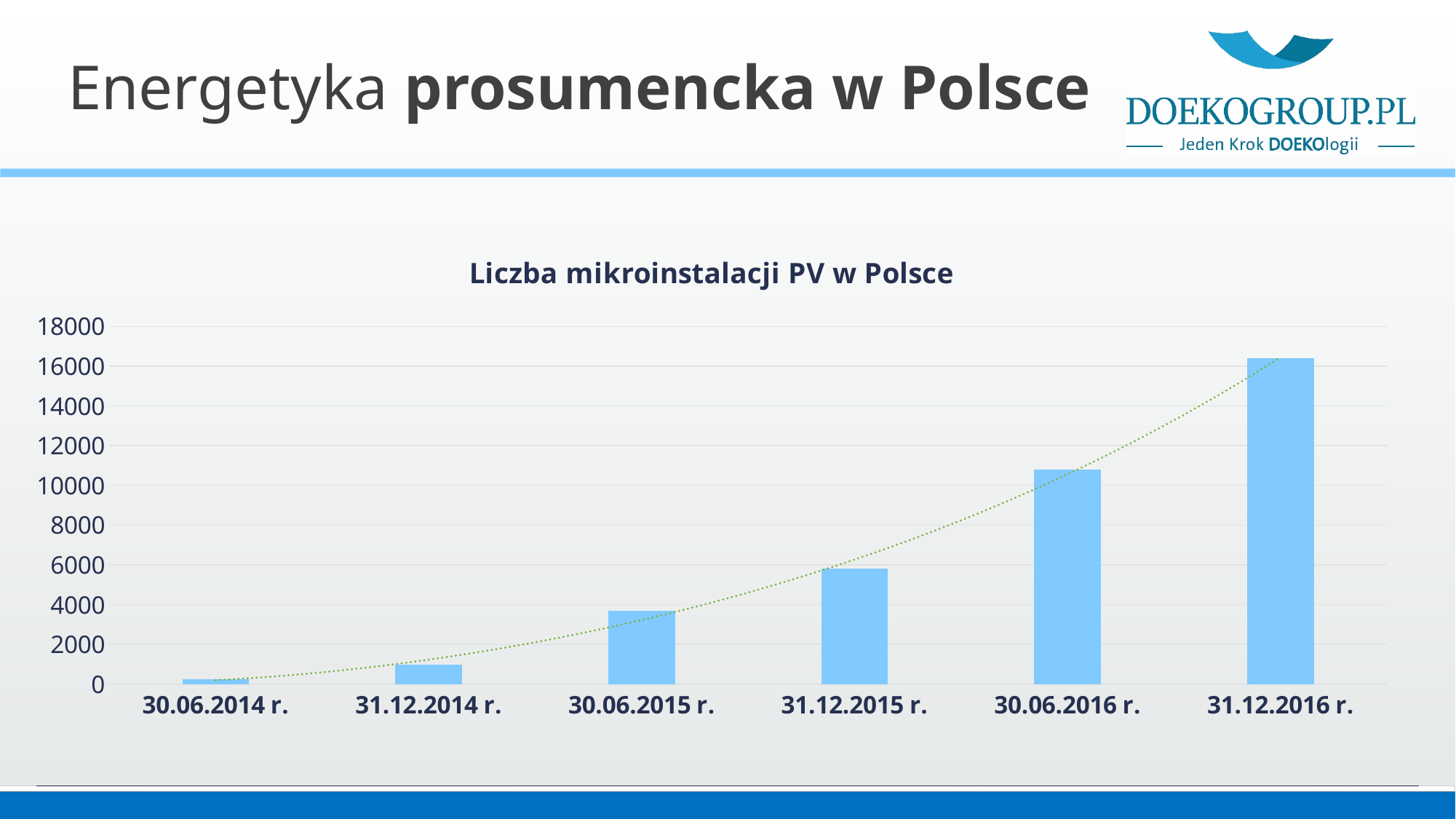
Which is larger, the value for 30.06.2016 r. or the value for 31.12.2015 r.? 30.06.2016 r. What is the highest value shown on the vertical axis of the chart? 18000 Is the value for 31.12.2014 r. greater or less than 2000? less What is the title of the chart? Liczba mikroinstalacji PV w Polsce Is the value for 30.06.2016 r. greater or less than 10000? greater Which date has the highest number of PV micro-installations? 31.12.2016 r. Which date has the lowest number of PV micro-installations? 30.06.2014 r. Is the value for 31.12.2016 r. greater or less than 14000? greater Do the values rise or fall from 30.06.2014 r. to 31.12.2016 r.? rise What kind of chart is shown on the slide? bar chart How many dates (categories) are shown on the x axis of the chart? 6